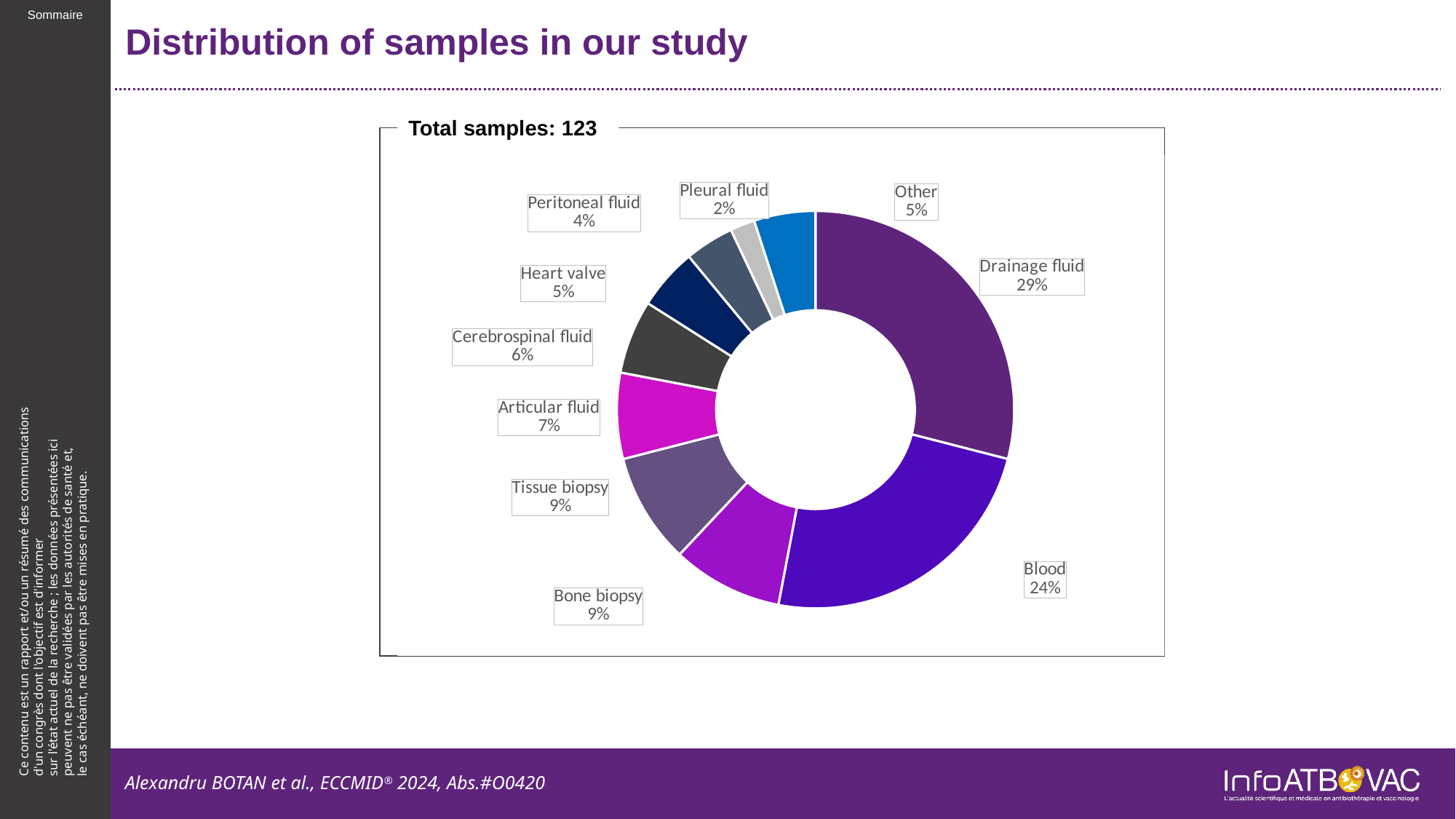
How many sample categories are shown in the chart? 10 What is the total number of samples stated on the chart? 123 Which sample type has the largest share? Drainage fluid What percentage of samples is pleural fluid? 2% Which sample type has the smallest share? Pleural fluid What is the difference in percentage points between drainage fluid and blood? 5 What is the title of the slide? Distribution of samples in our study What kind of chart is shown on the slide? Doughnut chart What percentage of samples is cerebrospinal fluid? 6% What share of samples is blood? 24% What share of samples is drainage fluid? 29% Which has a larger share, articular fluid or heart valve? Articular fluid